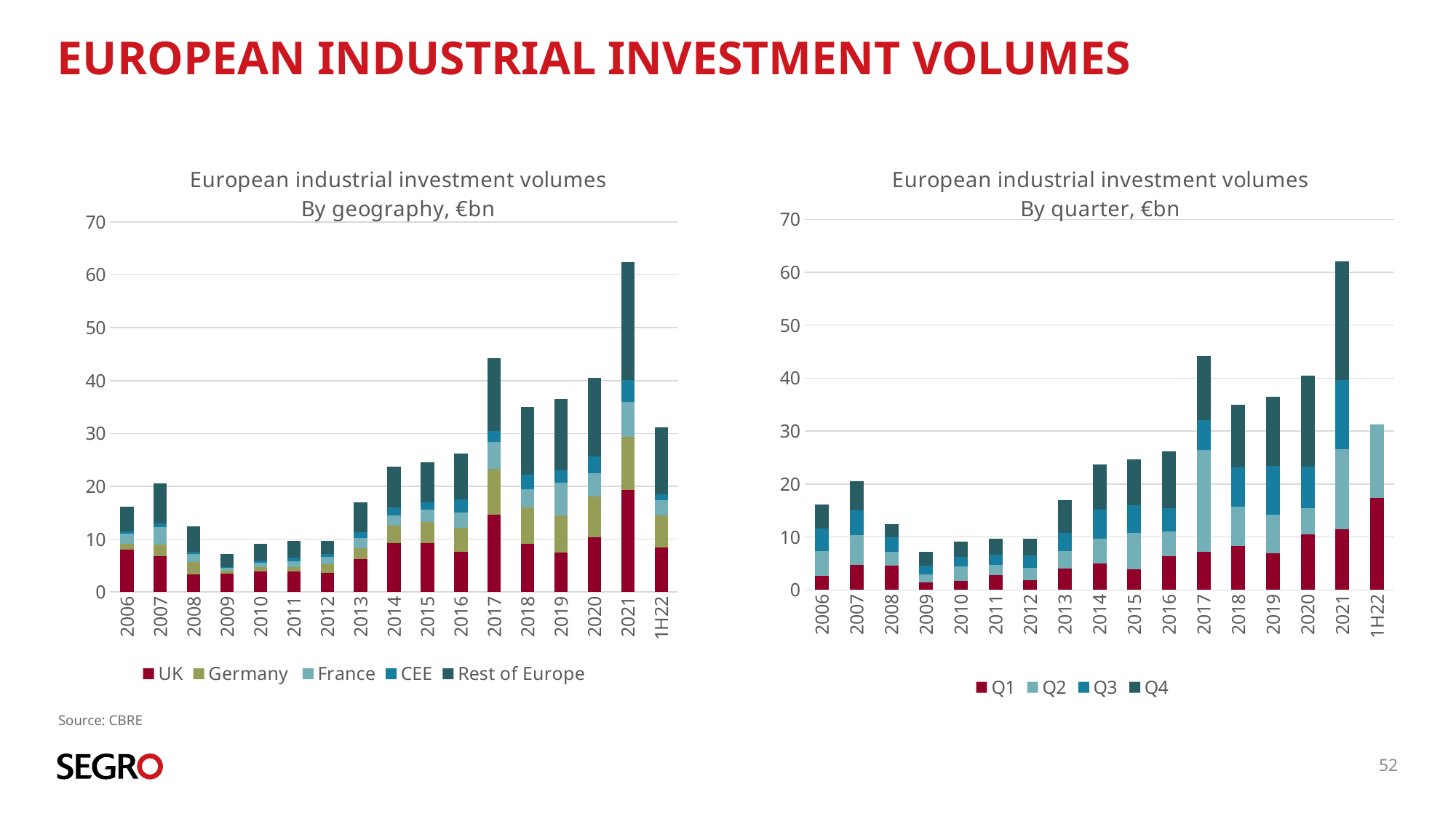
In the 'By quarter' chart, is the total for 2017 greater or less than 40? greater In the 'By quarter' chart, which quarters are included in the 1H22 bar? Q1 and Q2 In the 'By geography' chart, is the total for 2009 greater or less than 10? less In the 'By geography' chart, which year has the lowest total investment volume? 2009 In the 'By geography' chart, which year has the highest total investment volume? 2021 How many periods are shown on the x axis of the 'By quarter' chart? 17 In the 'By quarter' chart, is the total for 2021 greater or less than 60? greater In the 'By quarter' chart, which total is larger, 2017 or 2018? 2017 What kind of chart is the 'By geography' chart on the left? stacked bar chart How many series does the legend of the 'By geography' chart list? 5 How many series does the legend of the 'By quarter' chart list? 4 In the 'By geography' chart, which series is shown in red at the bottom of each bar? UK